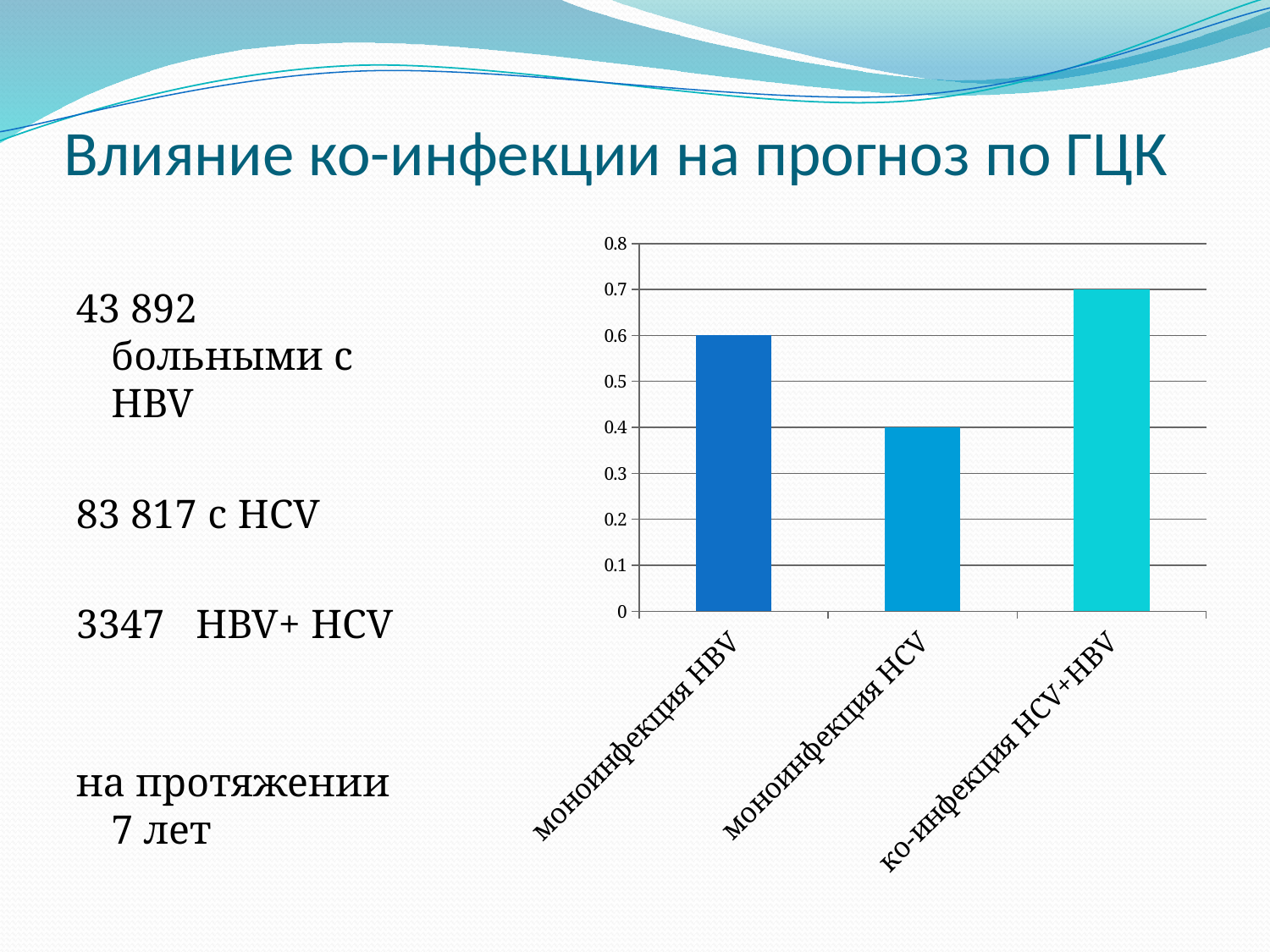
What kind of chart is shown on the slide? bar chart What is the difference between the values for моноинфекция HBV and моноинфекция HCV? 0.2 What is the value for ко-инфекция HCV+HBV? 0.7 What is the maximum value shown on the vertical axis of the chart? 0.8 Which category has the lowest value? моноинфекция HCV What is the value for моноинфекция HCV? 0.4 Which is larger, the value for моноинфекция HBV or the value for ко-инфекция HCV+HBV? ко-инфекция HCV+HBV What is the value for моноинфекция HBV? 0.6 What is the difference between the values for ко-инфекция HCV+HBV and моноинфекция HCV? 0.3 Which category has the highest value? ко-инфекция HCV+HBV How many categories are plotted in the bar chart? 3 Is the value for моноинфекция HCV greater or less than 0.5? less